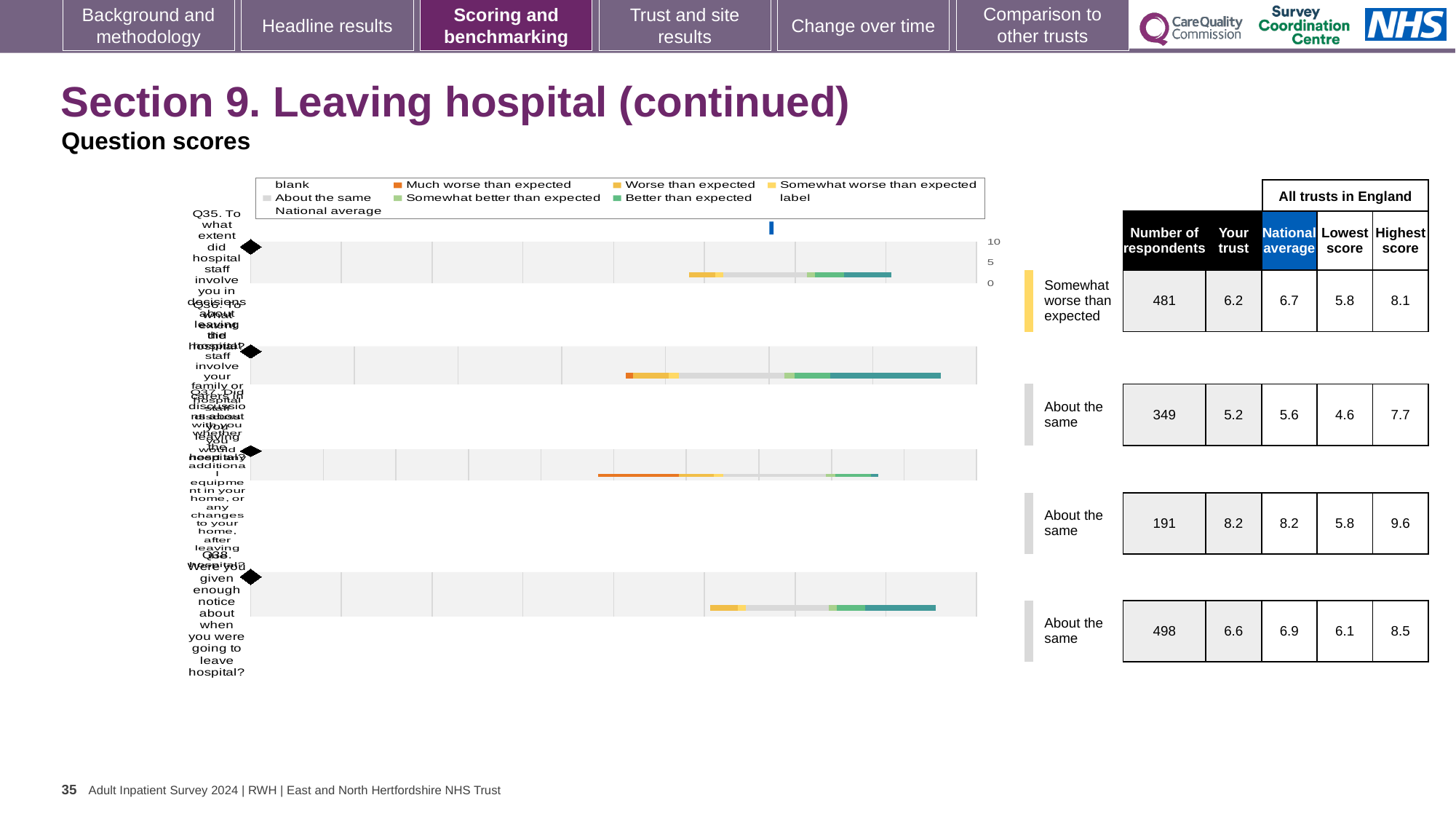
What benchmark category is shown for Q35? Somewhat worse than expected Which row has the highest 'Your trust' score? the third row (8.2) How many rows are labelled 'About the same'? 3 What is the 'Your trust' score for Q35 (involving you in decisions about leaving hospital)? 6.2 How many questions (rows) are plotted in the chart? 4 Which row has the lowest number of respondents? the third row (191) What is the highest score across all trusts in England for Q38? 8.5 What is the difference between the national average and the 'Your trust' score for Q35? 0.5 How many respondents are listed for Q38 (given enough notice about leaving hospital)? 498 What is the lowest score across all trusts in England for the second row? 4.6 What kind of chart is shown on the slide? bar chart Which has the higher 'Your trust' score, Q35 or Q38? Q38